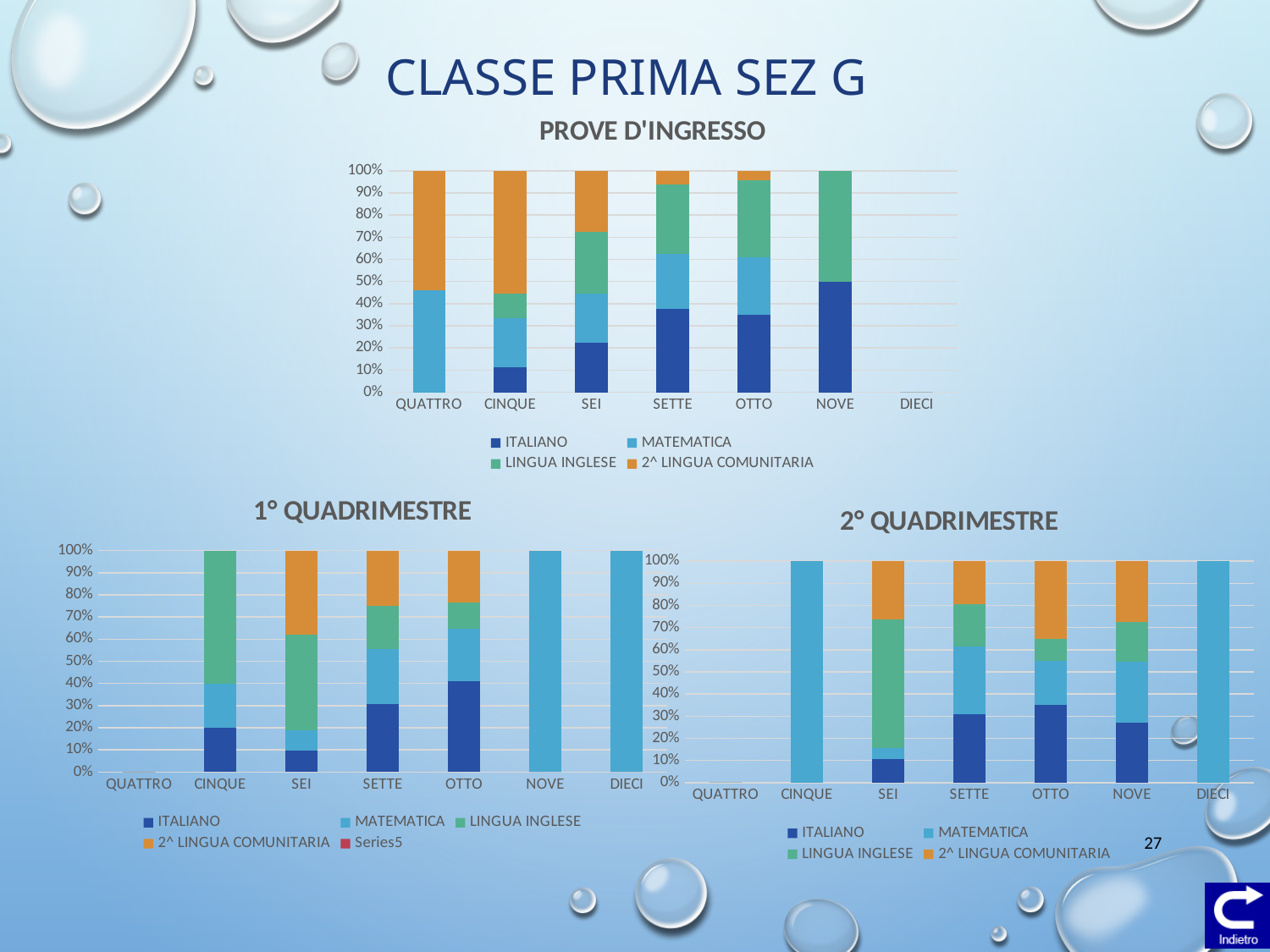
What kind of chart is the PROVE D'INGRESSO chart? Stacked bar chart In the PROVE D'INGRESSO chart, is the ITALIANO segment larger for SETTE or for CINQUE? SETTE In the 1° QUADRIMESTRE chart, which category has the largest ITALIANO segment? OTTO In the 2° QUADRIMESTRE chart, which series makes up the entire bar for DIECI? MATEMATICA How many categories are shown on the x axis of the PROVE D'INGRESSO chart? 7 In the 1° QUADRIMESTRE chart, what is the name of the fifth legend entry? Series5 In the PROVE D'INGRESSO chart, is the ITALIANO segment for SEI greater or less than 30%? less How many series does the legend of the PROVE D'INGRESSO chart list? 4 In the PROVE D'INGRESSO chart, which category has the largest ITALIANO segment? NOVE What is the title of the chart at the top of the slide? PROVE D'INGRESSO In the 2° QUADRIMESTRE chart, is the ITALIANO segment for OTTO greater or less than 20%? greater How many series does the legend of the 1° QUADRIMESTRE chart list? 5